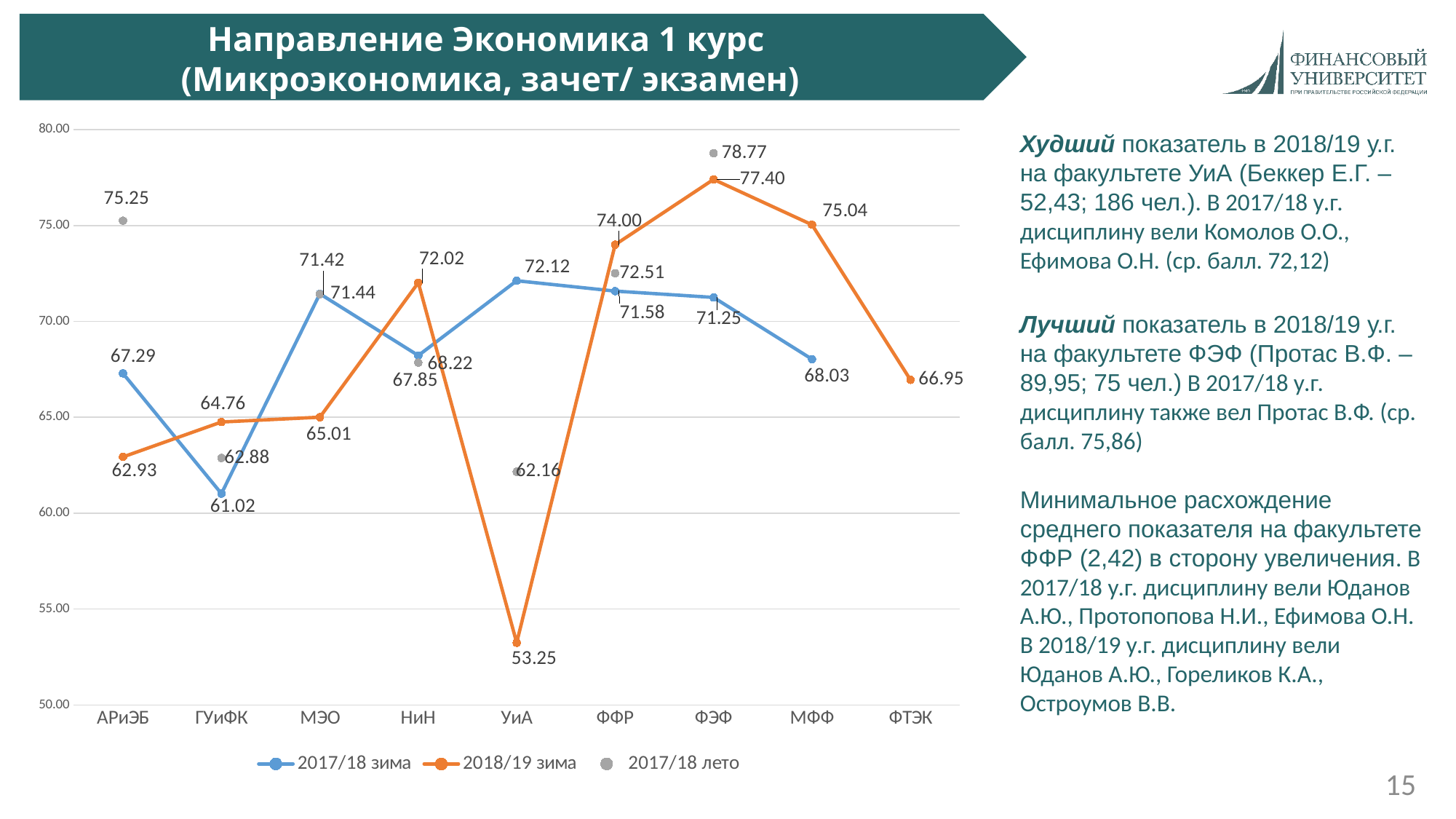
What is the value for ГУиФК in the 2017/18 зима series? 61.02 How many series does the legend list? 3 What is the value for ФЭФ in the 2017/18 лето series? 78.77 For АРиЭБ, which is higher: the 2017/18 зима value or the 2018/19 зима value? 2017/18 зима What kind of chart is shown on the slide? line chart How many faculties are shown on the x axis? 9 Which faculty has the lowest value in the 2018/19 зима series? УиА Which series is drawn in orange? 2018/19 зима What is the value for УиА in the 2018/19 зима series? 53.25 Which faculty has the highest value in the 2018/19 зима series? ФЭФ What is the difference between the 2018/19 зима and 2017/18 зима values for ФЭФ? 6.15 What is the value for ФТЭК in the 2018/19 зима series? 66.95